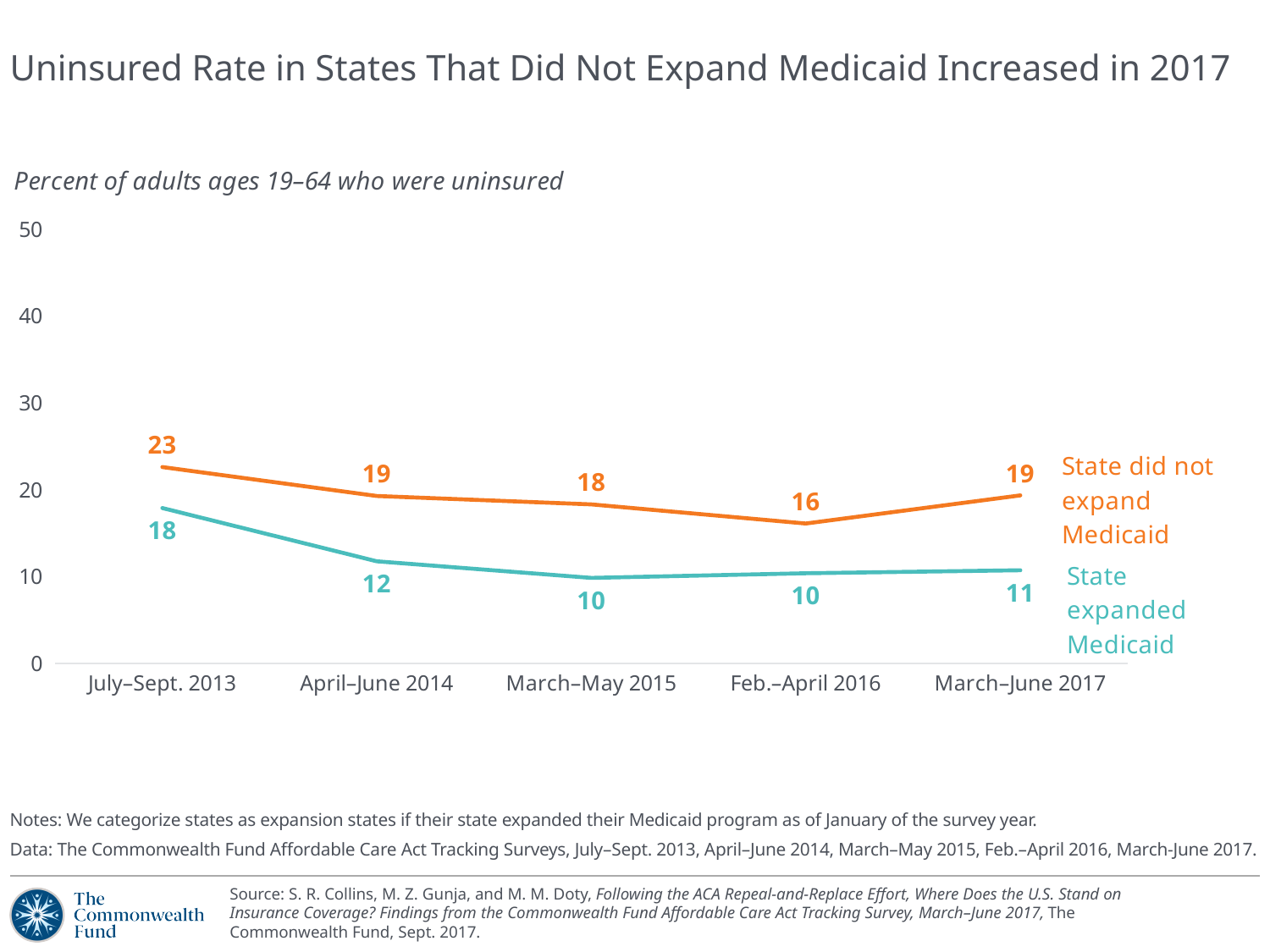
Is the uninsured rate for states that expanded Medicaid in July–Sept. 2013 greater or less than 20? less What was the uninsured rate for states that expanded Medicaid in March–June 2017? 11 Which group had the higher uninsured rate in April–June 2014: states that expanded Medicaid or states that did not? State did not expand Medicaid What type of chart is shown on the slide? Line chart What is the difference between the uninsured rates of non-expansion and expansion states in March–June 2017? 8 What was the uninsured rate for states that did not expand Medicaid in Feb.–April 2016? 16 By how much did the uninsured rate in states that did not expand Medicaid change from Feb.–April 2016 to March–June 2017? 3 What was the uninsured rate for states that did not expand Medicaid in July–Sept. 2013? 23 What was the lowest uninsured rate shown for states that expanded Medicaid? 10 In which survey period was the uninsured rate for states that did not expand Medicaid highest? July–Sept. 2013 How many series are plotted on the chart? 2 How many survey periods are shown on the x axis? 5